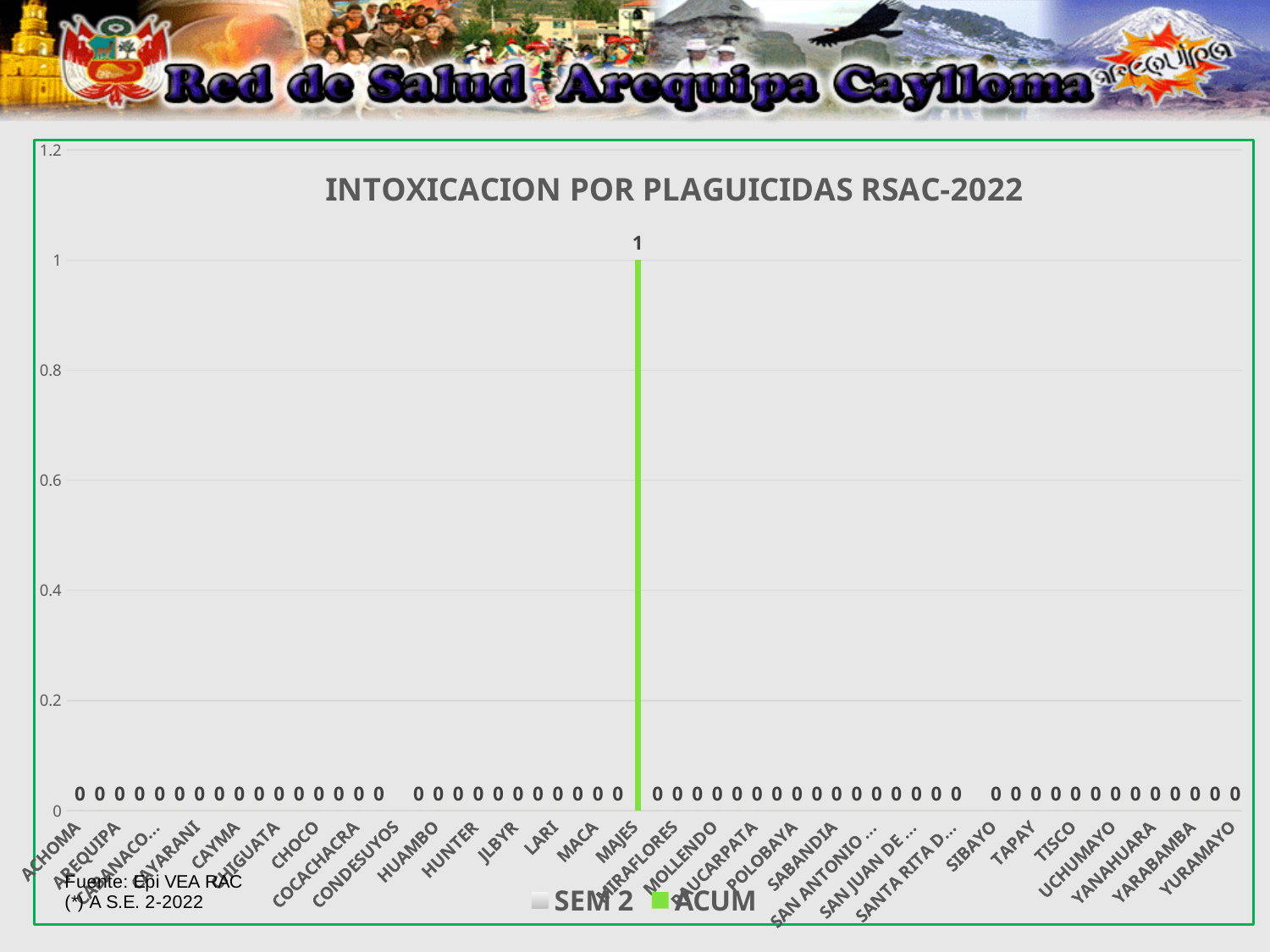
How many series does the legend list? 2 Which category has the highest ACUM value? MAJES What is the value shown for HUAMBO? 0 Which is larger, the ACUM value for MAJES or for CAYMA? MAJES What is the title of the chart? INTOXICACION POR PLAGUICIDAS RSAC-2022 What is the value shown for TISCO? 0 What is the ACUM value for MAJES? 1 Is the value for CHOCO greater or less than 0.2? less What is the difference between the ACUM value for MAJES and the value for LARI? 1 What kind of chart is shown on the slide? bar chart What are the two series named in the legend? SEM 2 and ACUM Is the ACUM value for MAJES greater or less than 0.8? greater